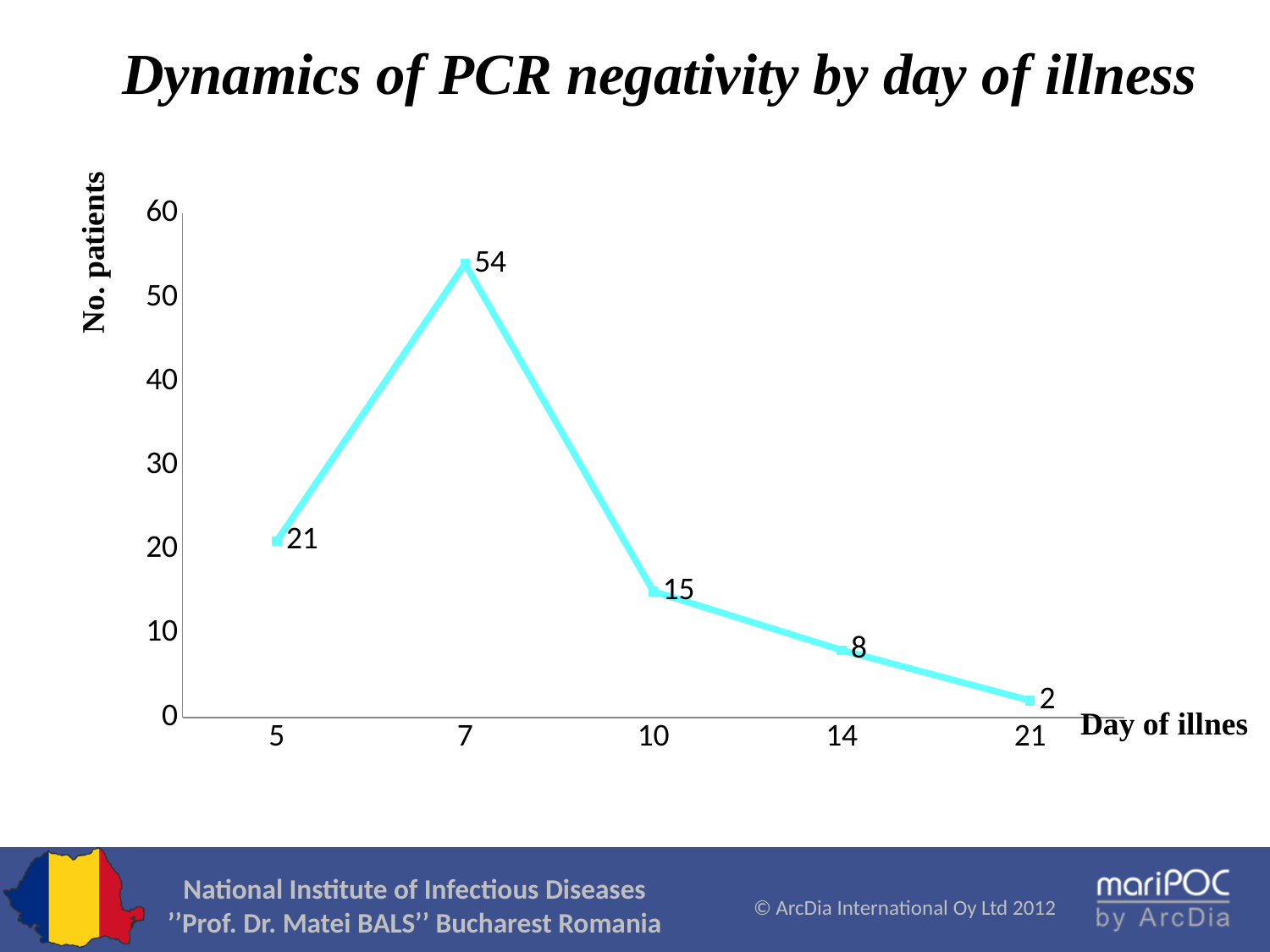
What is the title of the chart? Dynamics of PCR negativity by day of illness On which day of illness is the number of patients lowest? 21 What is the difference in number of patients between day 5 and day 14? 13 Do the values rise or fall from day 7 to day 21? fall What is the number of patients on day 21 of illness? 2 On which day of illness is the number of patients highest? 7 What kind of chart is shown on the slide? line chart How many data points are plotted on the chart? 5 What is the number of patients on day 5 of illness? 21 Which has more patients, day 10 or day 14? day 10 What is the difference in number of patients between day 7 and day 10? 39 What is the number of patients on day 7 of illness? 54